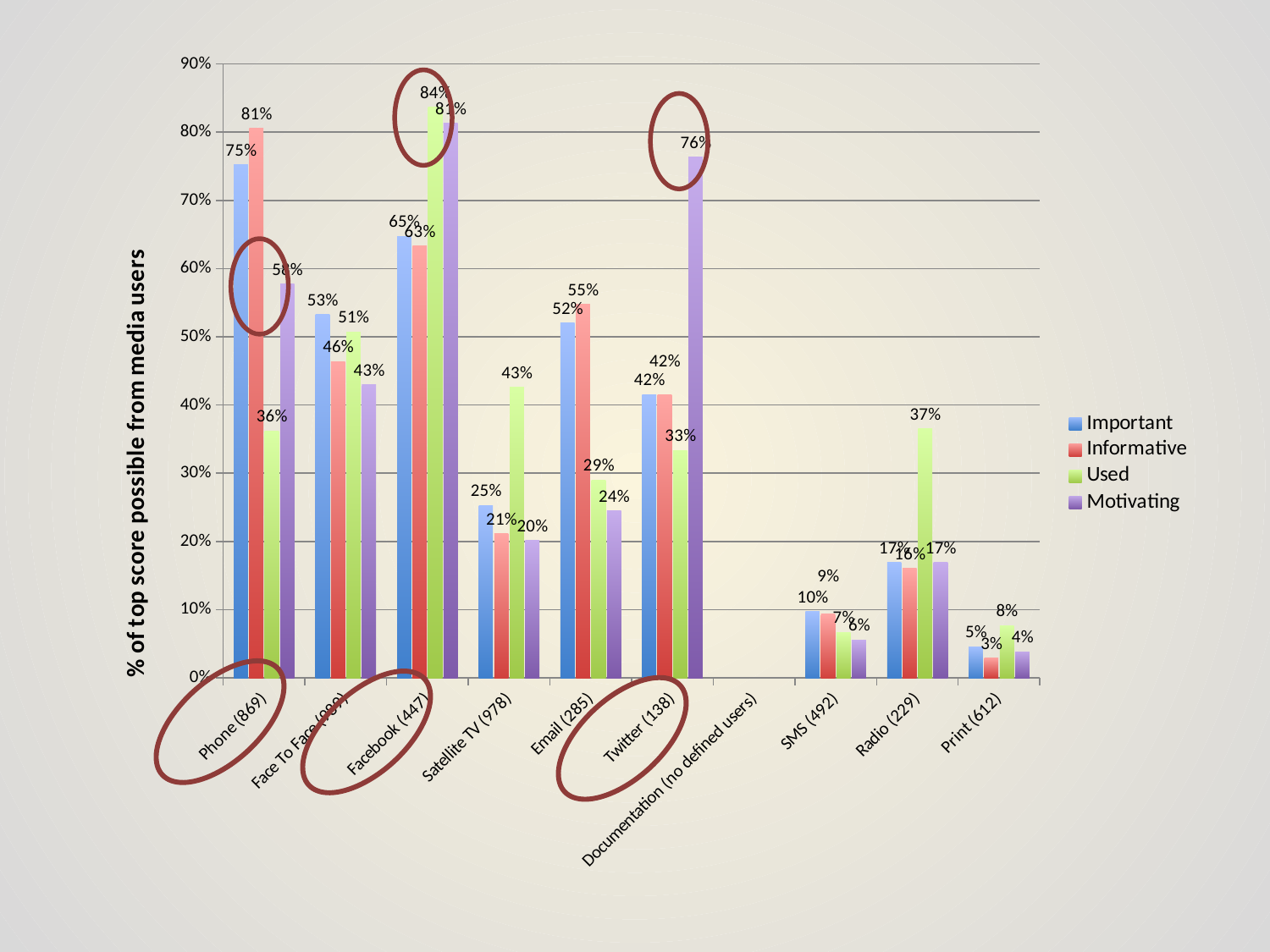
What is the title of the vertical axis? % of top score possible from media users What is the Important value for SMS (492)? 10% How many series does the legend list? 4 Which category has the lowest Informative value? Print (612) Which category has the highest Used value? Facebook (447) What is the Informative value for Phone (869)? 81% Which has a higher Used value, Satellite TV (978) or Email (285)? Satellite TV (978) What kind of chart is shown on the slide? Bar chart What is the Motivating value for Twitter (138)? 76% What is the Used value for Radio (229)? 37% How many categories are shown on the x axis? 10 What is the difference between the Informative and Used values for Email (285)? 26 percentage points